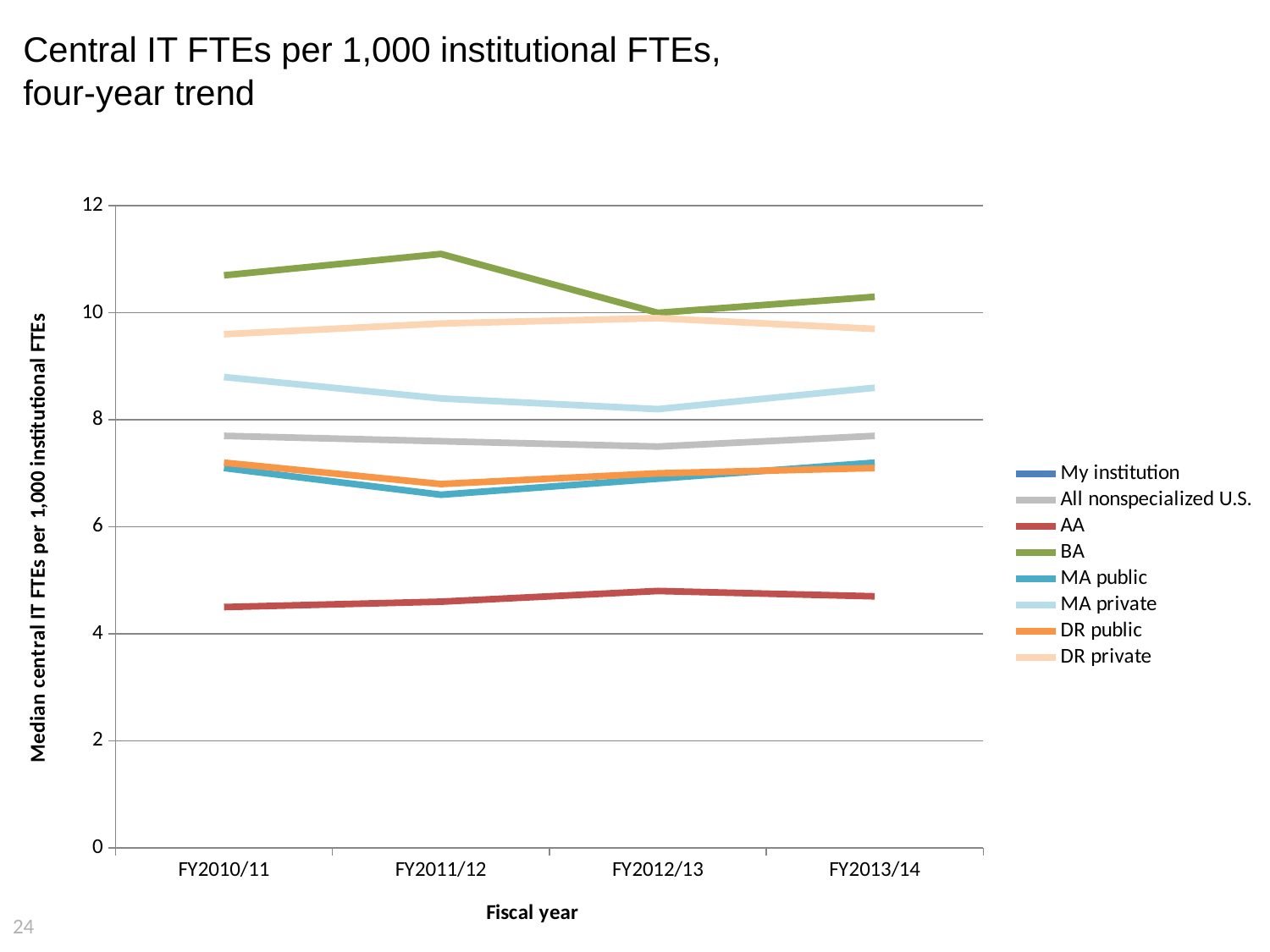
Which is larger in FY2013/14, the value for BA or the value for AA? BA Is the value for AA in FY2010/11 greater or less than 6? less What kind of chart is shown on the slide? line chart How many series does the legend list? 8 Is the value for BA in FY2011/12 greater or less than 10? greater Which series has the lowest value in FY2013/14? AA Does the BA line rise or fall from FY2011/12 to FY2012/13? fall Which series has the highest value in FY2011/12? BA Is the value for All nonspecialized U.S. in FY2013/14 greater or less than 8? less How many fiscal years are shown on the x axis? 4 What is the title of the y axis? Median central IT FTEs per 1,000 institutional FTEs